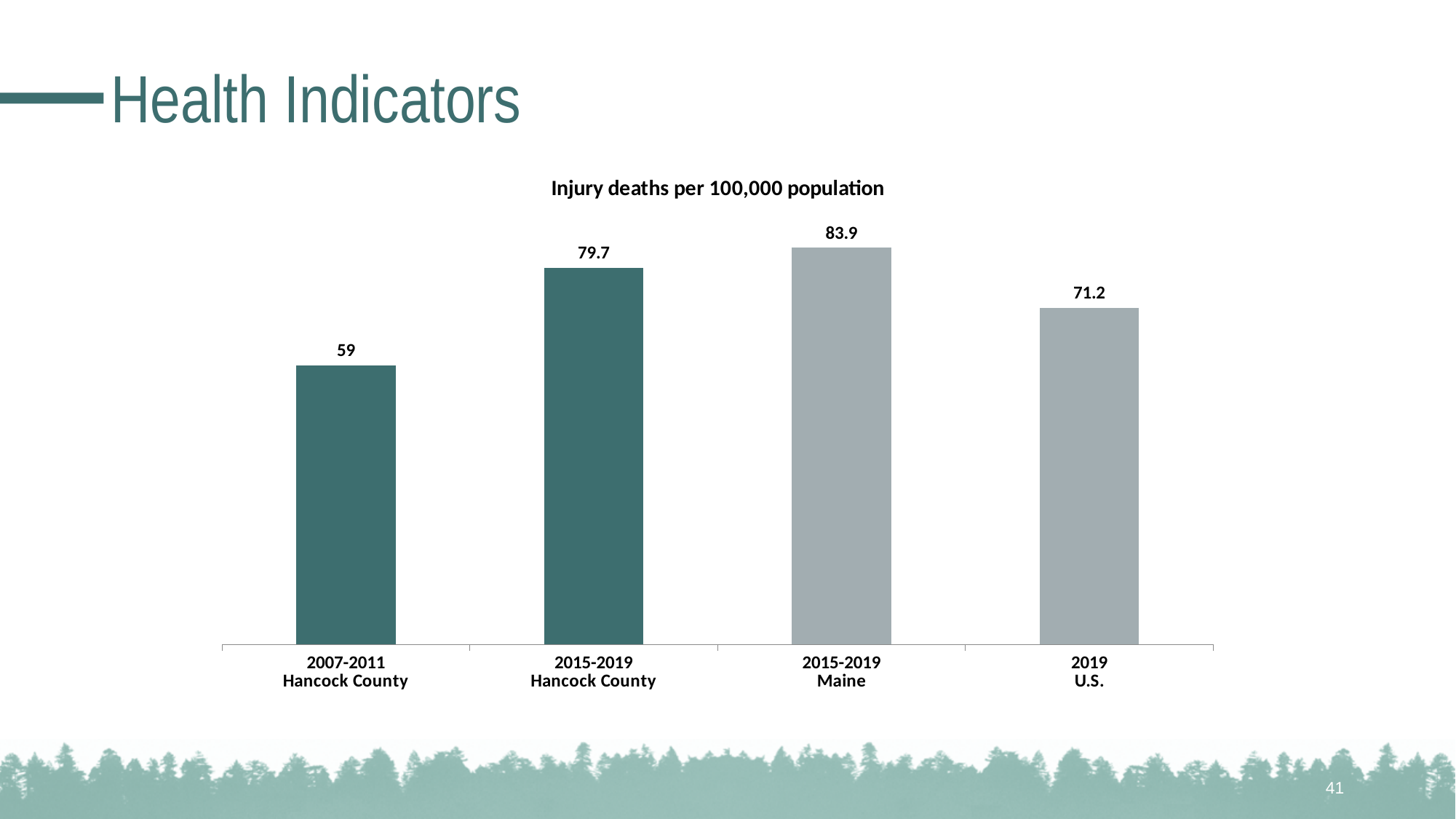
What is the value for 2007-2011 Hancock County? 59 What is the value for 2019 U.S.? 71.2 What is the value for 2015-2019 Hancock County? 79.7 Which category has the highest value? 2015-2019 Maine What is the value for 2015-2019 Maine? 83.9 What kind of chart is shown on the slide? Bar chart How many bars are shown in the chart? 4 What is the title of the chart? Injury deaths per 100,000 population Which is larger, the value for 2015-2019 Hancock County or the value for 2019 U.S.? 2015-2019 Hancock County What is the difference between the 2015-2019 Maine value and the 2019 U.S. value? 12.7 What is the difference between the 2015-2019 Hancock County value and the 2007-2011 Hancock County value? 20.7 Which category has the lowest value? 2007-2011 Hancock County